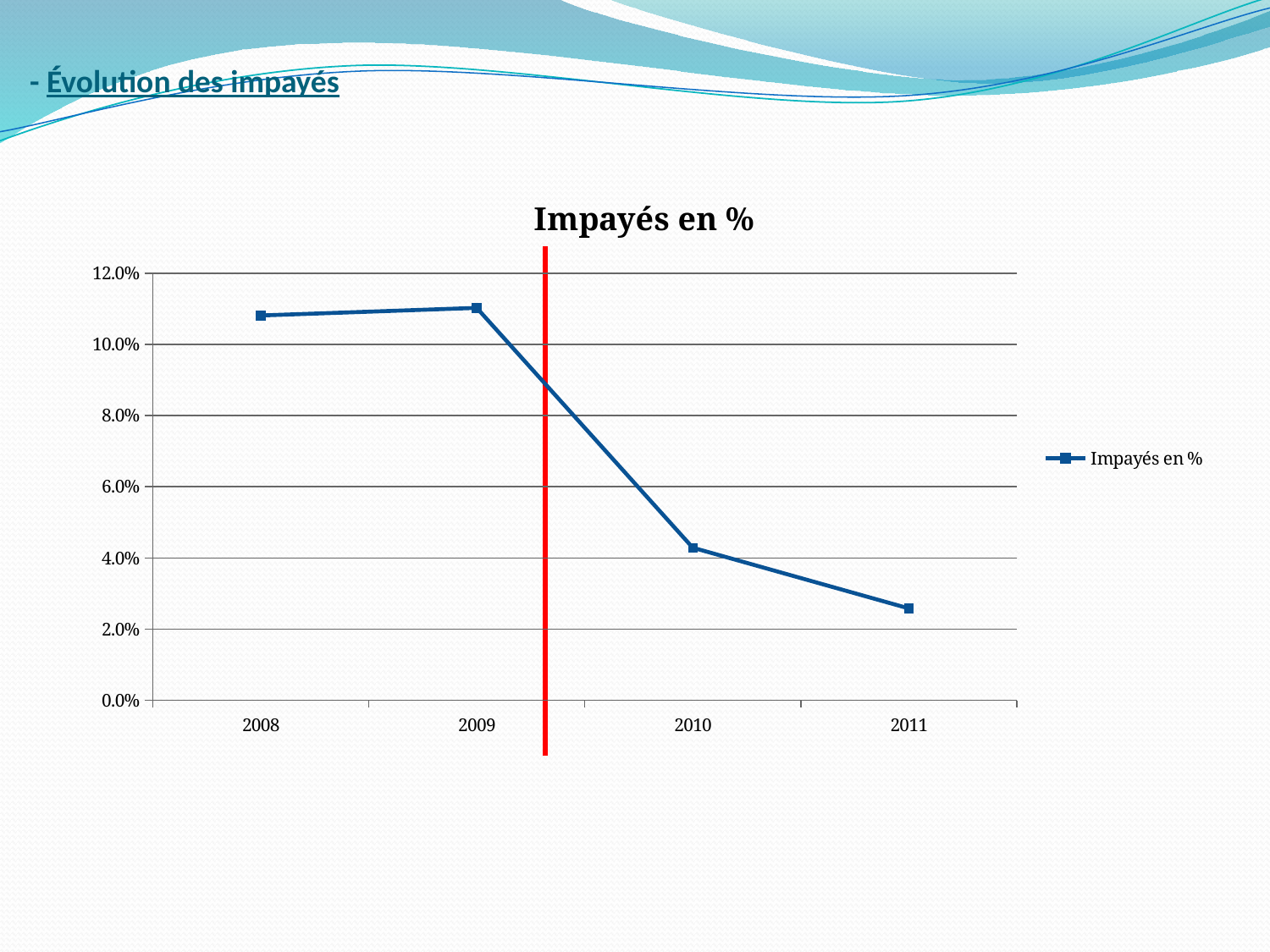
How many years are plotted on the x axis of the chart? 4 How many series does the legend list? 1 What is the title of the chart? Impayés en % What kind of chart is shown on the slide? line chart Is the value for 2009 greater or less than 10.0%? greater Do the values for Impayés en % rise or fall between 2009 and 2011? fall Is the value for 2011 greater or less than 4.0%? less Which year has the lowest value for Impayés en %? 2011 Is the value for 2009 larger or smaller than the value for 2010? larger Is the value for 2008 larger or smaller than the value for 2011? larger What is the name of the series shown in the legend? Impayés en % Is the value for 2010 greater or less than 6.0%? less